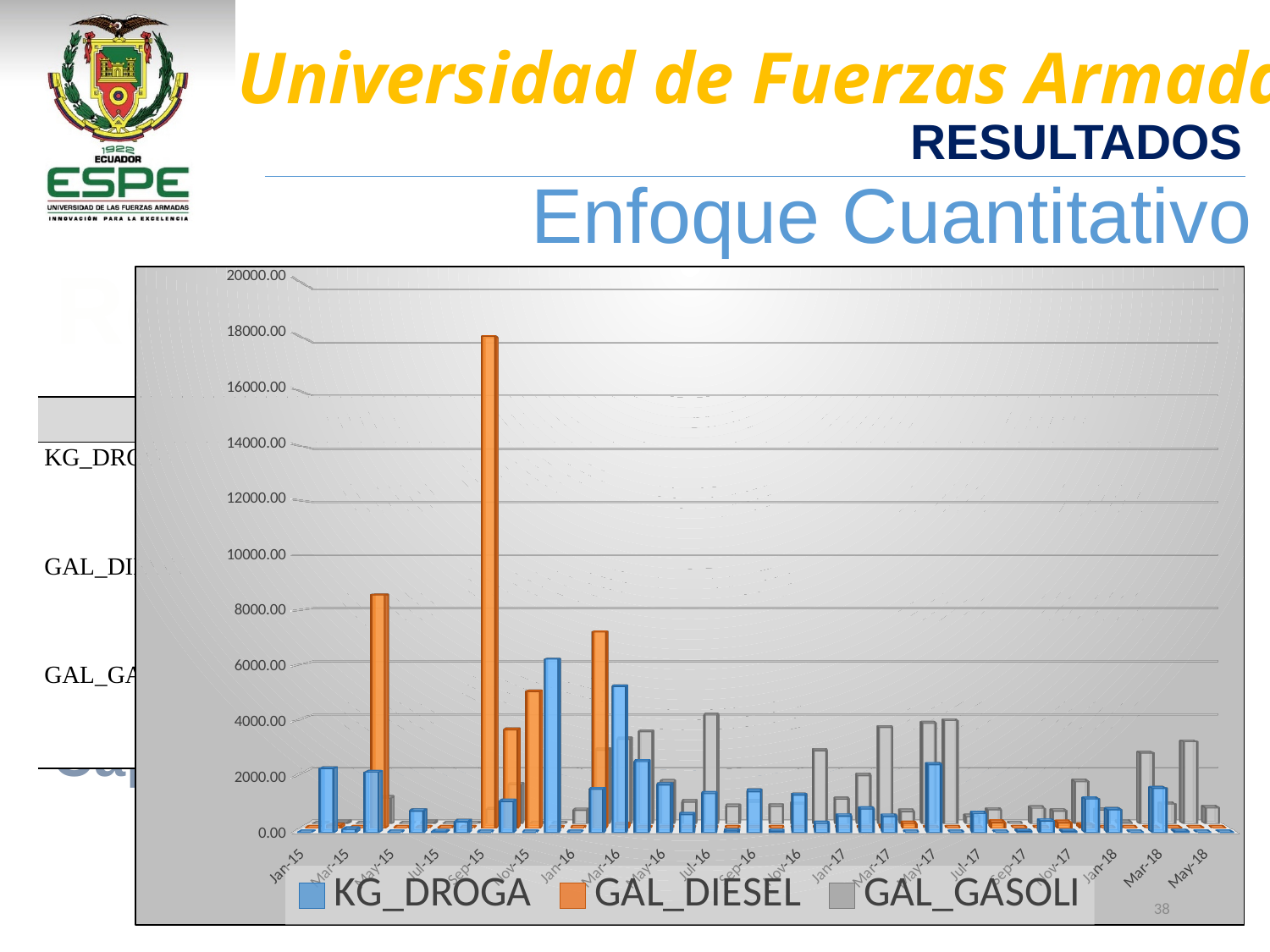
Is the tallest GAL_DIESEL bar (around Sep-15) greater or less than 16000.00? greater What colour represents the GAL_DIESEL series in the chart? orange Is the tallest KG_DROGA bar (around Jan-16) greater or less than 4000.00? greater Which is larger: the GAL_DIESEL bar at Sep-15 or the GAL_DIESEL bar at May-15? Sep-15 How many series does the chart legend list? 3 Is the tallest GAL_GASOLI bar greater or less than 6000.00? less What is the highest value shown on the y axis of the chart? 20000.00 Which series has the tallest bar in the chart? GAL_DIESEL What is the first label on the x axis of the chart? Jan-15 What kind of chart is shown on the slide? bar chart How many labels are shown on the x axis of the chart? 21